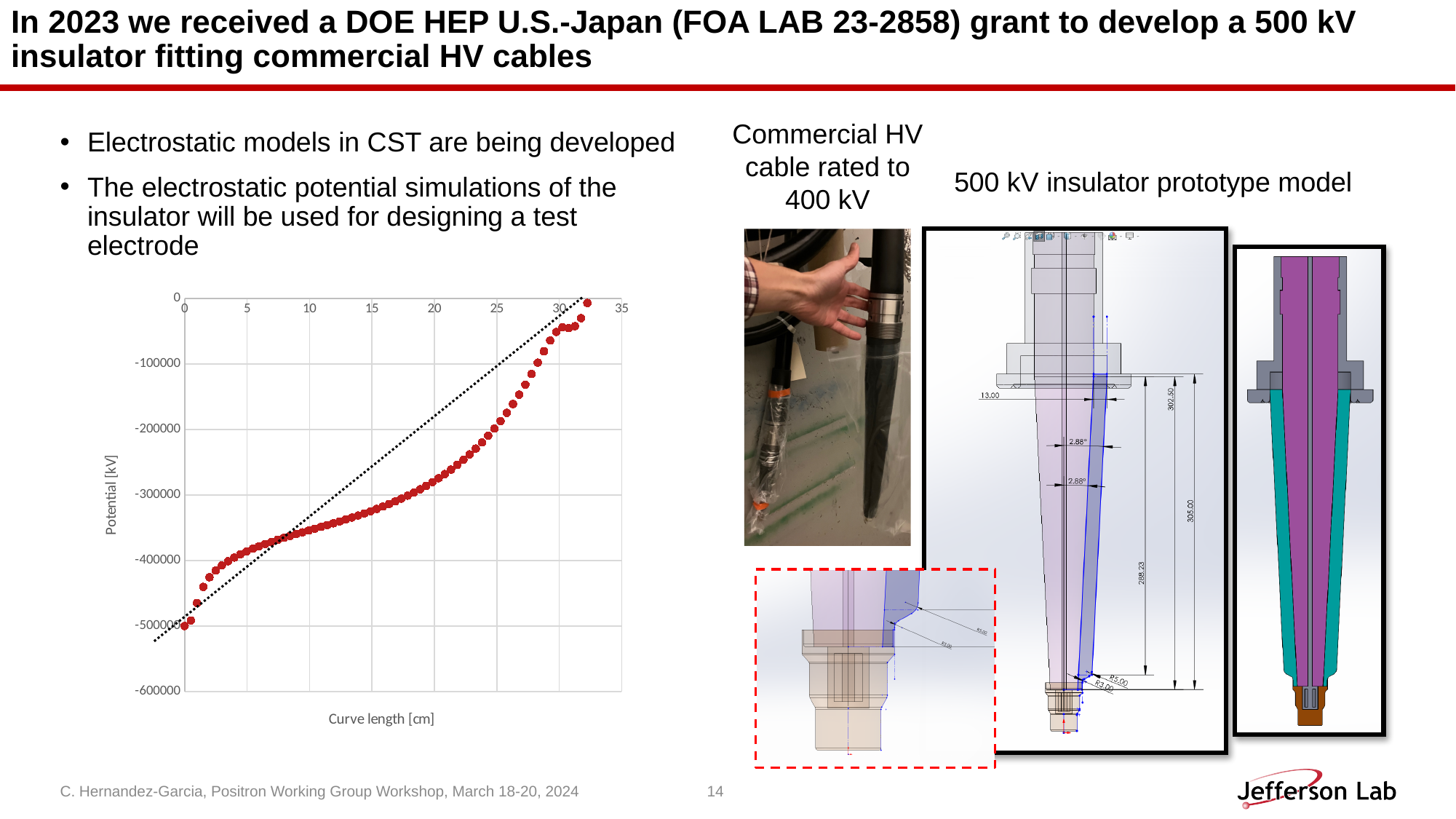
What is the largest tick value shown on the x axis of the chart? 35 What kind of chart is shown on the slide? scatter chart Is the potential at a curve length of 10 cm greater or less than -300000? less Is the potential at a curve length of 30 cm greater or less than -100000? greater Which has the larger potential value: the point at a curve length of 30 cm or the point at 5 cm? 30 cm Is the potential at a curve length of 5 cm greater or less than -300000? less What is the label of the y axis of the chart? Potential [kV] Do the plotted potential values rise or fall as curve length increases along the x axis? rise What is the label of the x axis of the chart? Curve length [cm] At which end of the curve length axis is the lowest (most negative) potential found? 0 cm